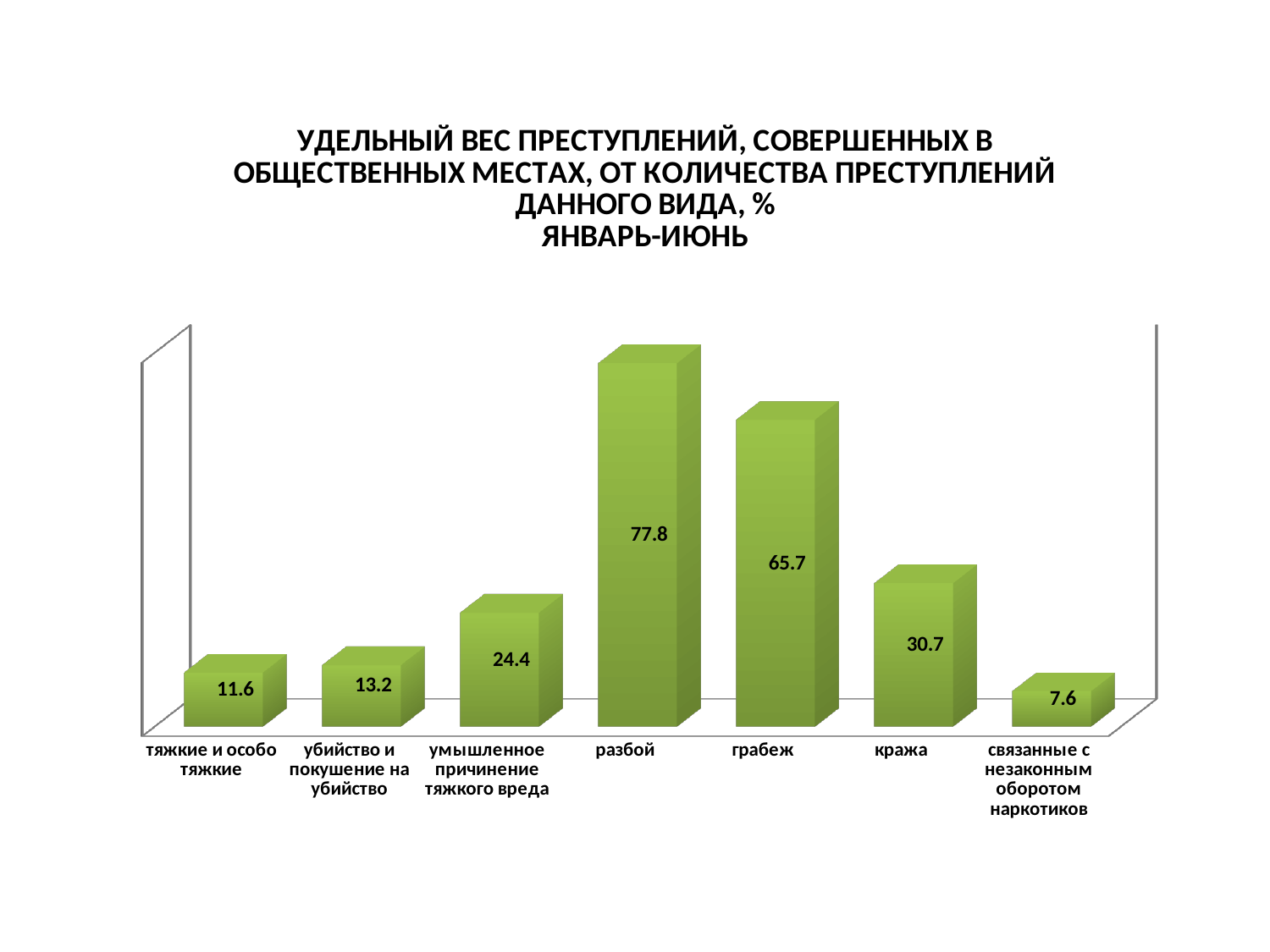
What period does the chart title say the data covers? январь-июнь What is the difference between the values for разбой and грабеж? 12.1 What colour are the bars in the chart? green What is the value for кража? 30.7 Which is larger, the value for убийство и покушение на убийство or the value for умышленное причинение тяжкого вреда? умышленное причинение тяжкого вреда What is the difference between the values for кража and связанные с незаконным оборотом наркотиков? 23.1 Which category has the lowest value? связанные с незаконным оборотом наркотиков What kind of chart is shown on the slide? bar chart How many categories are shown in the chart? 7 What is the value for тяжкие и особо тяжкие? 11.6 Which category has the highest value? разбой What is the value for разбой? 77.8